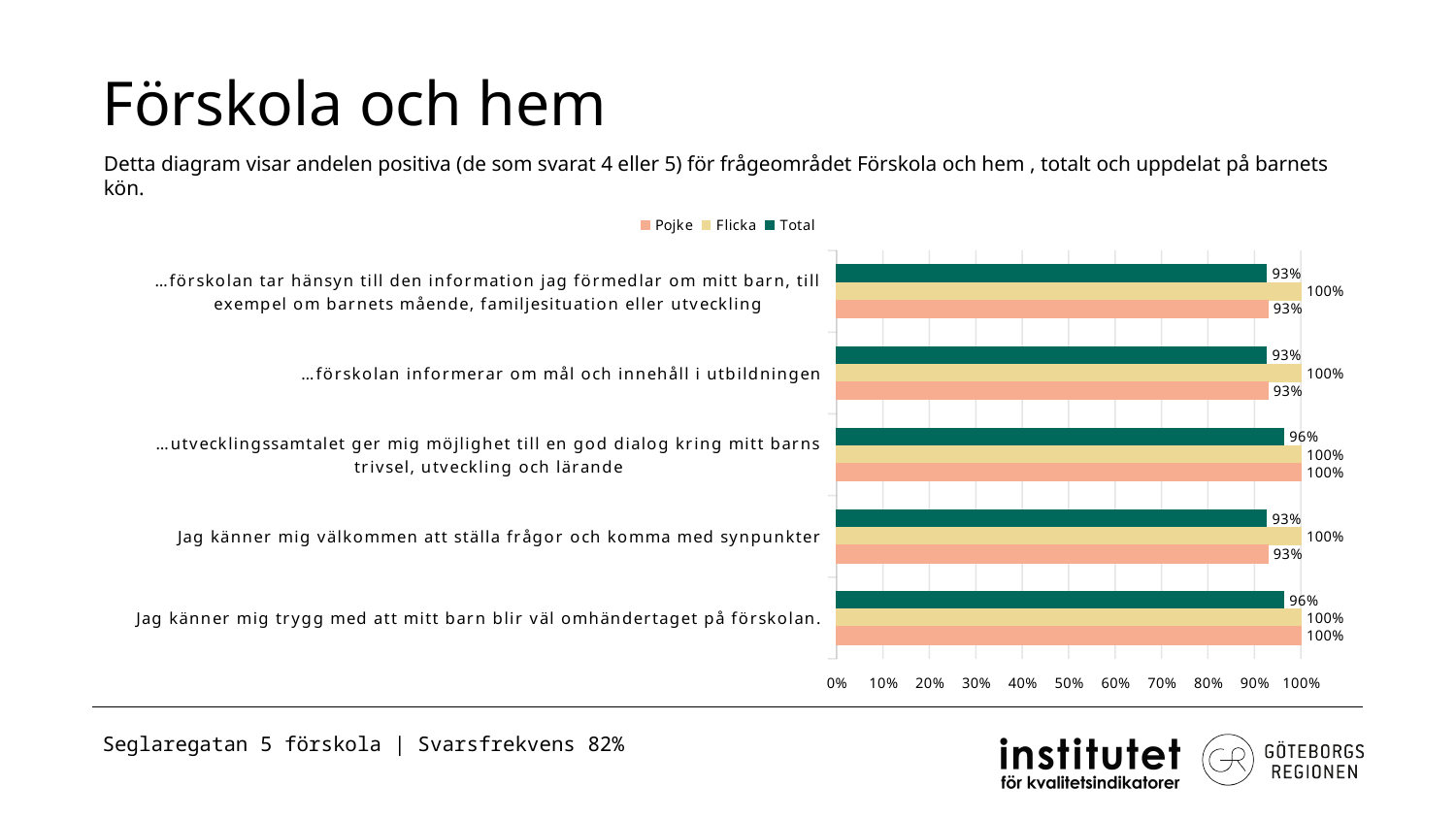
How many series does the legend list? 3 What is the difference between the Flicka and Pojke values for "…förskolan tar hänsyn till den information jag förmedlar om mitt barn, till exempel om barnets mående, familjesituation eller utveckling"? 7% What is the Flicka value for "…förskolan informerar om mål och innehåll i utbildningen"? 100% What is the Pojke value for "Jag känner mig trygg med att mitt barn blir väl omhändertaget på förskolan."? 100% What is the title of the slide containing the chart? Förskola och hem What is the Total value for "…utvecklingssamtalet ger mig möjlighet till en god dialog kring mitt barns trivsel, utveckling och lärande"? 96% How many statements (categories) are plotted on the chart? 5 For "Jag känner mig välkommen att ställa frågor och komma med synpunkter", which is larger, the Flicka value or the Pojke value? Flicka What kind of chart is shown on the slide? bar chart Which series is shown in green on the chart? Total What is the Total value for "Jag känner mig välkommen att ställa frågor och komma med synpunkter"? 93%